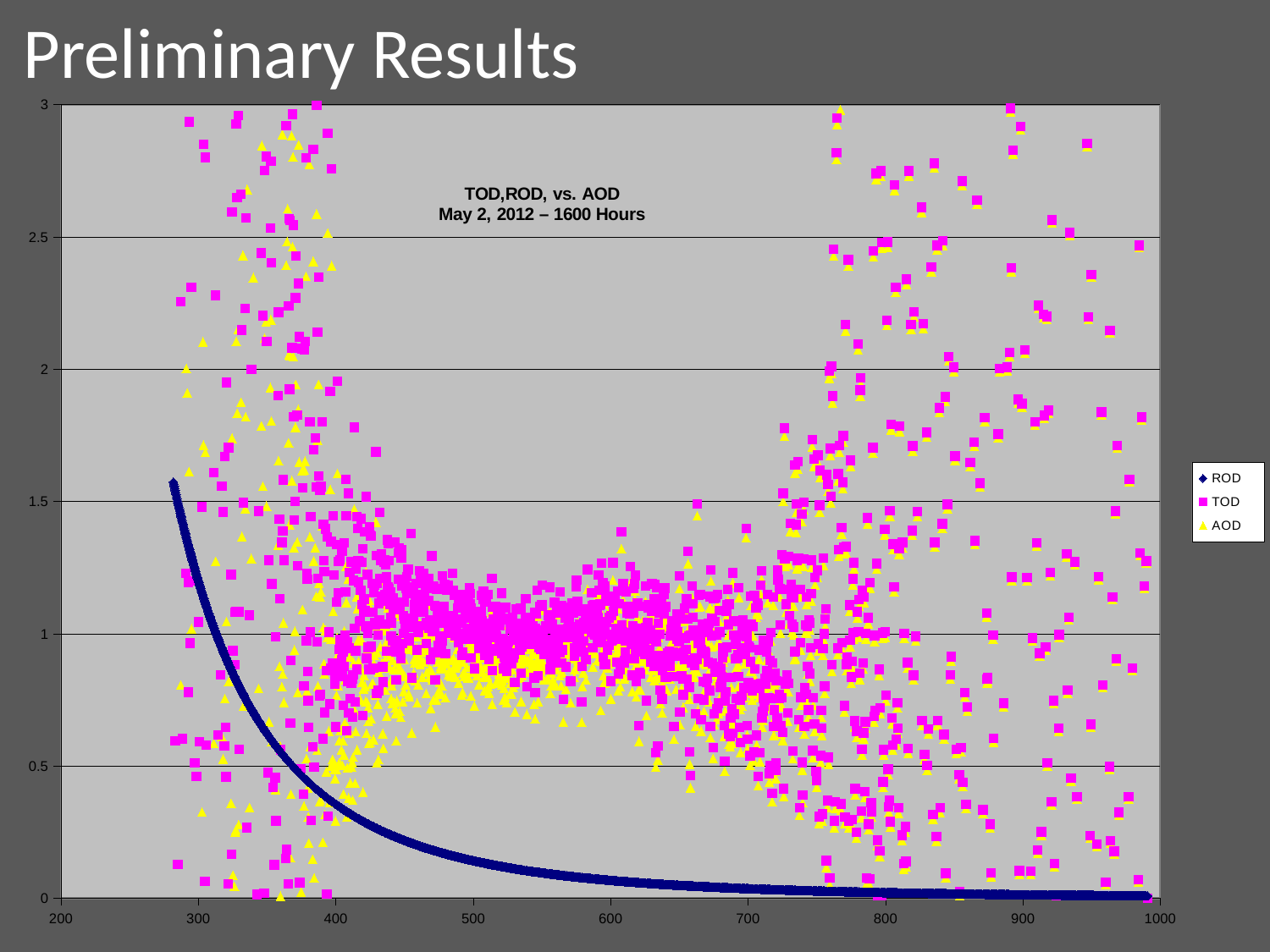
What kind of chart is shown on the slide? scatter chart Is the ROD value at x = 900 greater or less than 0.5? less Does the ROD series rise or fall as the x-axis value increases? fall What is the highest value shown on the y-axis? 3 Which series is plotted with yellow triangle markers? AOD Is the ROD value at x = 600 greater or less than 0.5? less What is the title of the chart? TOD,ROD, vs. AOD May 2, 2012 – 1600 Hours Is the ROD value at x = 400 greater or less than 0.5? less How many series does the legend list? 3 At x = 500, which series has the larger value, ROD or TOD? TOD